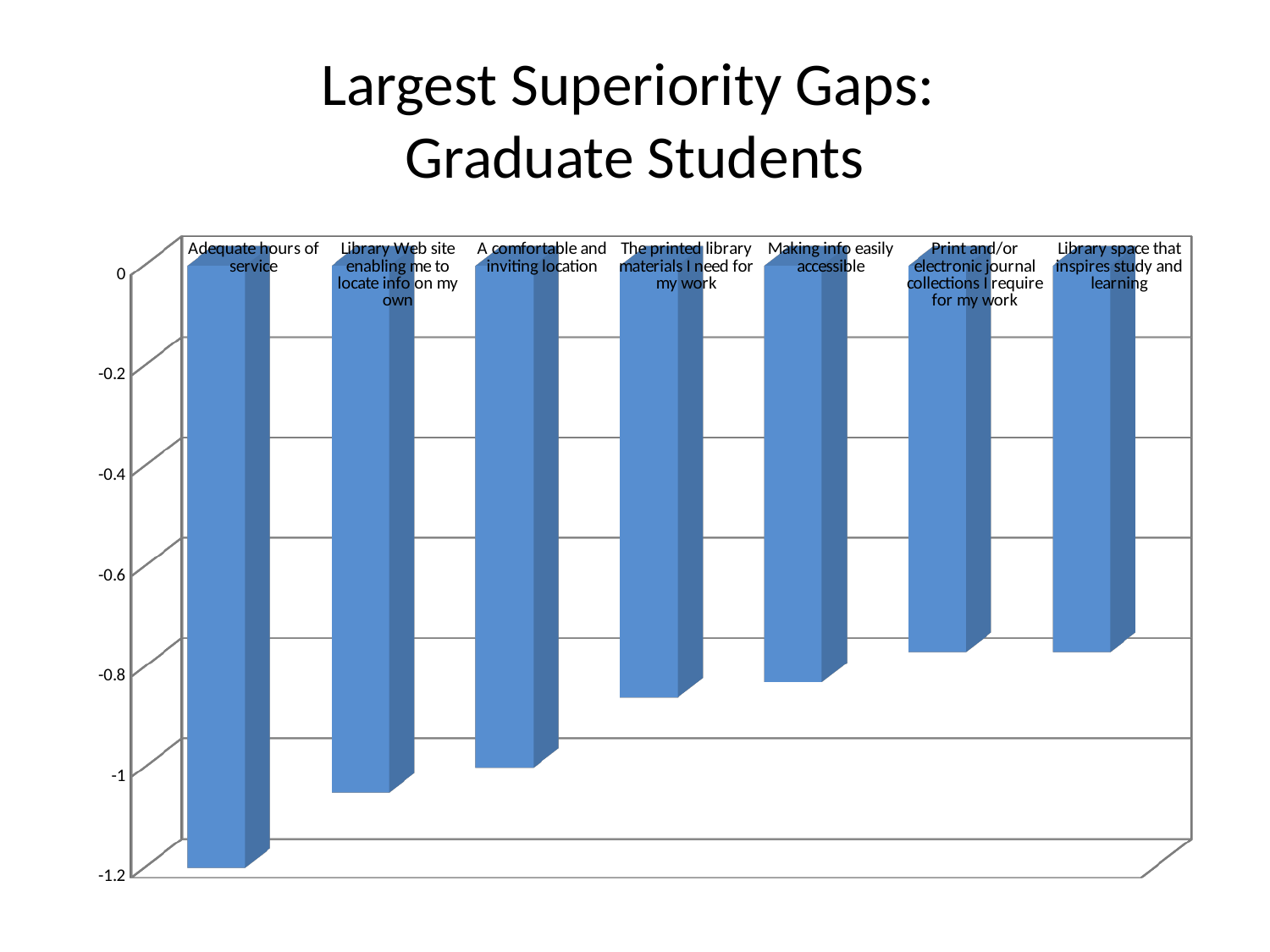
How many categories are plotted in the chart? 7 Is the value for The printed library materials I need for my work greater or less than -0.6? less Do the values rise or fall moving from left to right along the x axis? rise Which category has the lowest (most negative) value? Adequate hours of service Which is larger, the value for Library Web site enabling me to locate info on my own or the value for Print and/or electronic journal collections I require for my work? Print and/or electronic journal collections I require for my work What is the lowest value shown on the vertical axis? -1.2 Which is larger, the value for Adequate hours of service or the value for Library space that inspires study and learning? Library space that inspires study and learning What is the title of the chart? Largest Superiority Gaps: Graduate Students Is the value for Adequate hours of service greater or less than -1? less What kind of chart is shown on the slide? bar chart